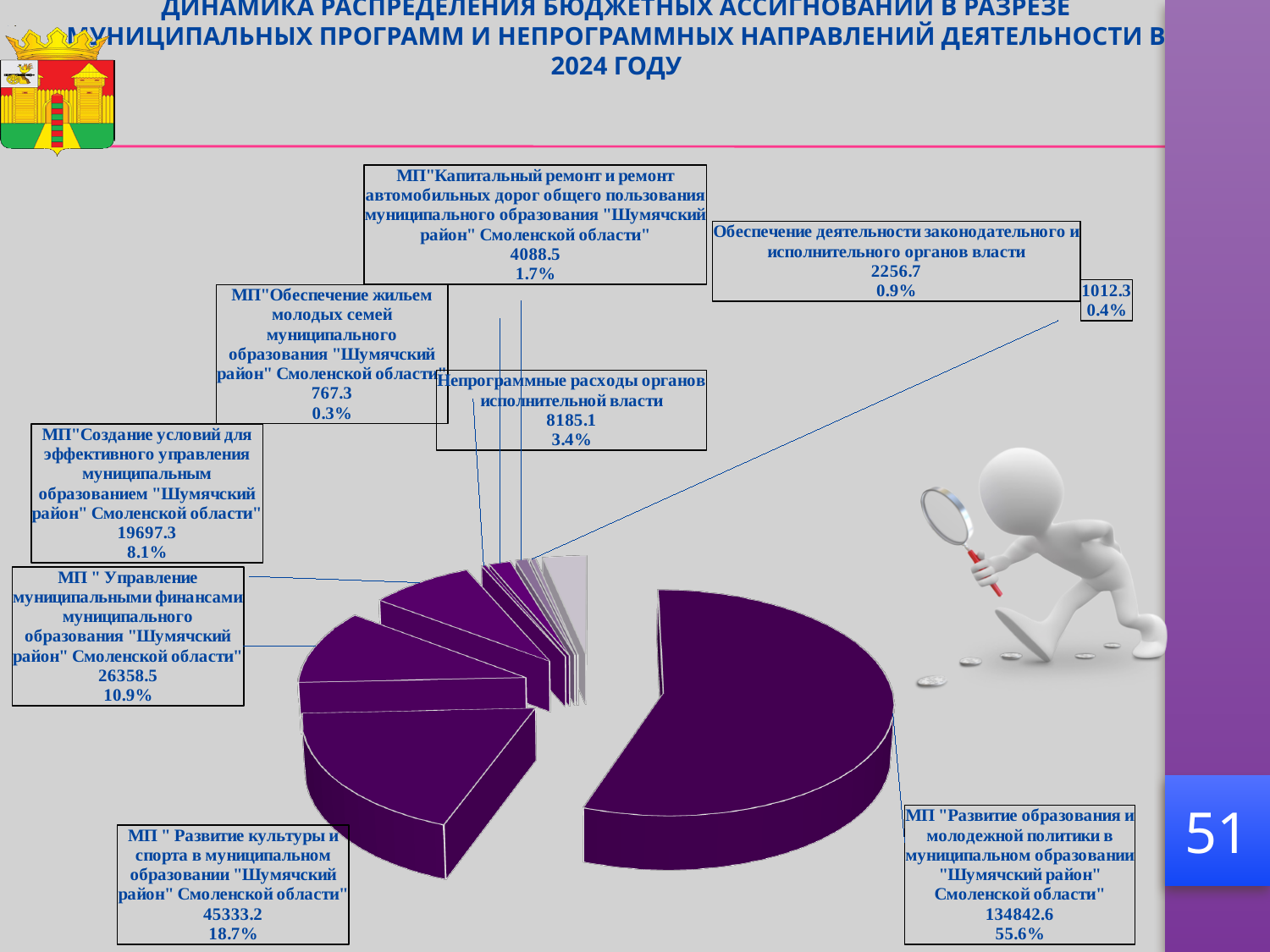
What is the difference between the values for МП "Развитие культуры и спорта" and МП "Управление муниципальными финансами"? 18974.7 What type of chart is shown on the slide? pie chart Which is larger: the value for МП "Создание условий для эффективного управления" or Непрограммные расходы органов исполнительной власти? МП "Создание условий для эффективного управления" Which category has the largest share of the pie? МП "Развитие образования и молодежной политики" What percentage is shown for МП "Управление муниципальными финансами"? 10.9% What is the value for Непрограммные расходы органов исполнительной власти? 8185.1 What is the value for МП "Развитие образования и молодежной политики"? 134842.6 What share of the pie does МП "Развитие образования и молодежной политики" represent? 55.6% What year does the chart title refer to? 2024 What percentage is shown for МП "Обеспечение жильем молодых семей"? 0.3% What is the value for МП "Развитие культуры и спорта"? 45333.2 Which named category has the smallest value? МП "Обеспечение жильем молодых семей"